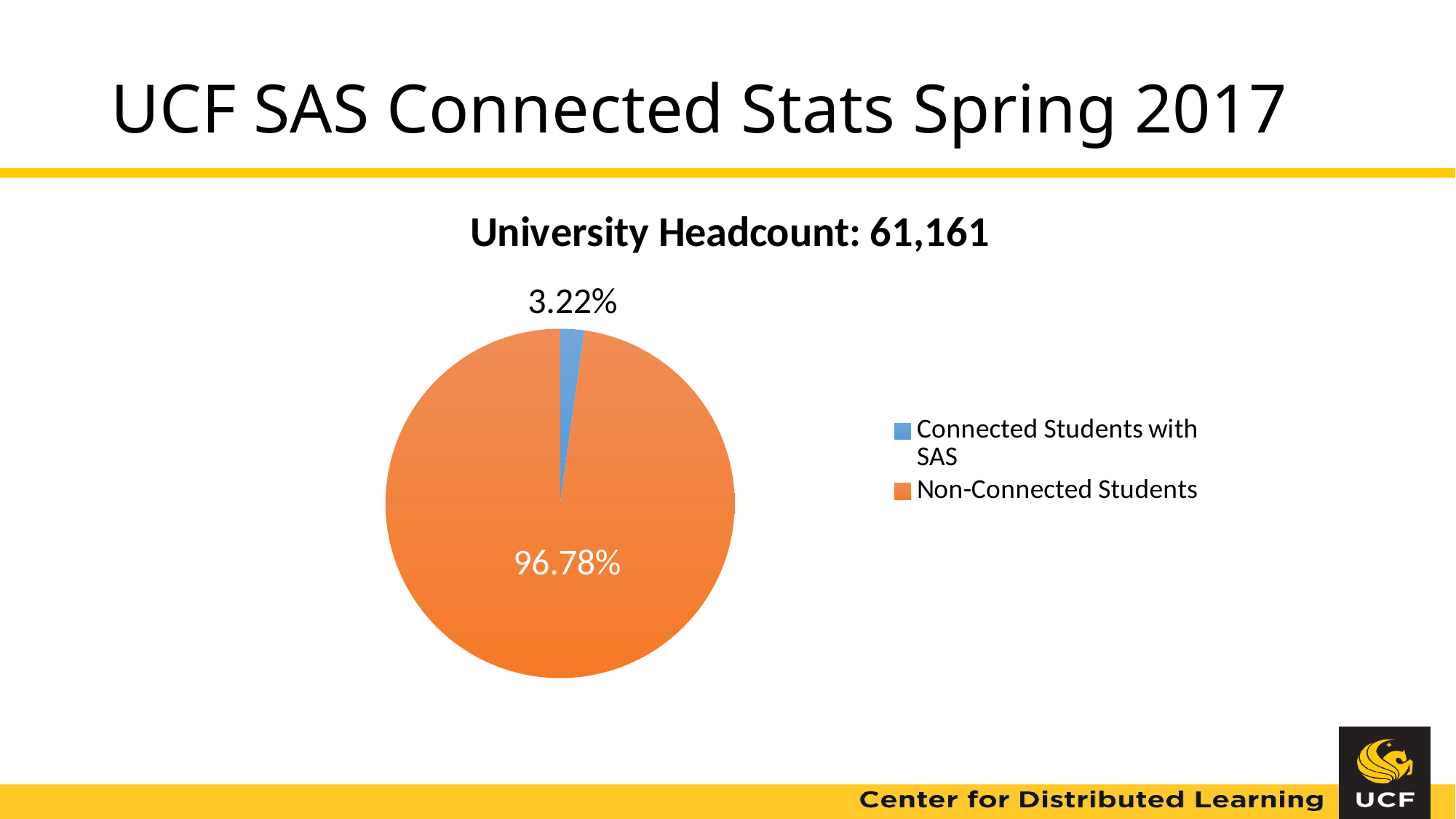
What colour is the Connected Students with SAS slice? Blue Which slice of the pie is the smallest? Connected Students with SAS What share of the pie is labelled for Non-Connected Students? 96.78% What is the difference in percentage points between the Non-Connected Students slice and the Connected Students with SAS slice? 93.56 Which is larger: the Connected Students with SAS slice or the Non-Connected Students slice? Non-Connected Students What share of the pie is labelled for Connected Students with SAS? 3.22% What is the title of the chart? University Headcount: 61,161 Which slice of the pie is the largest? Non-Connected Students How many slices does the pie chart have? 2 How many entries does the legend list? 2 What kind of chart is shown on the slide? Pie chart